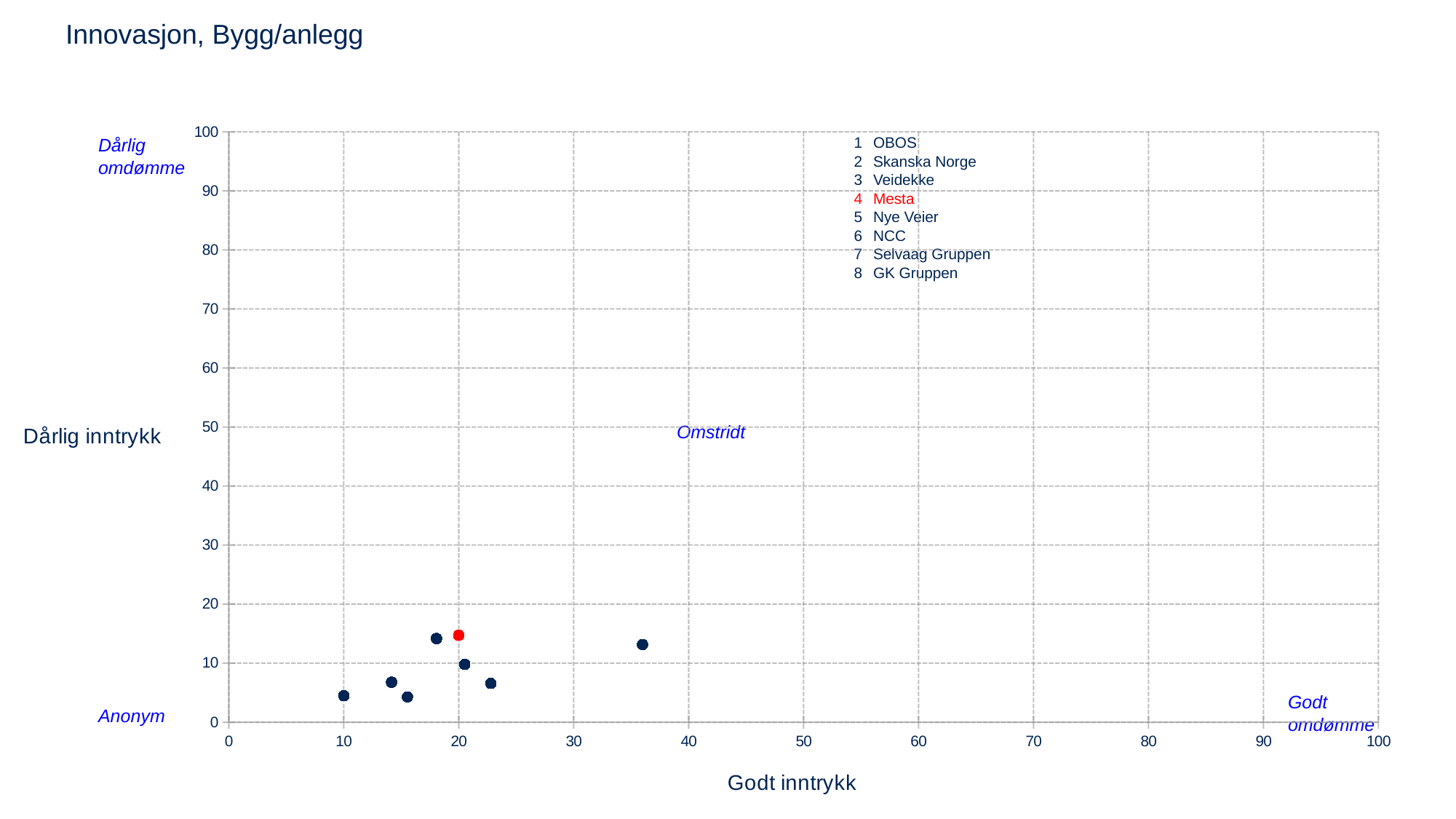
Is the y-axis (Dårlig inntrykk) value for the red point (Mesta) greater or less than 10? greater How many data points are plotted on the chart? 8 Which company in the legend is highlighted in red? Mesta Is the x-axis (Godt inntrykk) value for the red point (Mesta) greater or less than 10? greater How many companies are listed in the chart's legend? 8 Is the x-axis (Godt inntrykk) value for the red point (Mesta) greater or less than 30? less What is the title of the slide? Innovasjon, Bygg/anlegg What kind of chart is shown on the slide? scatter chart